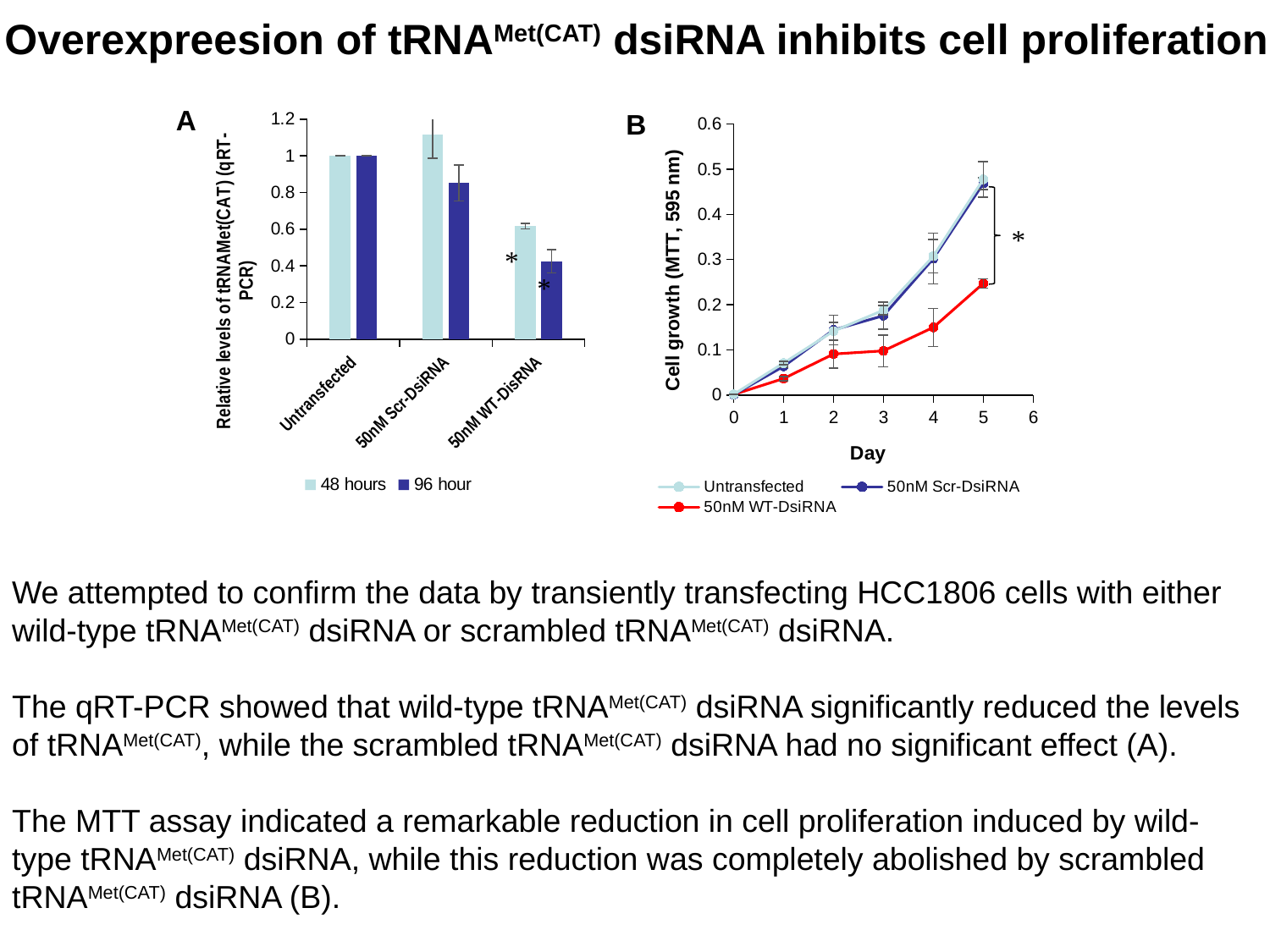
In chart A, how many categories are shown on the x axis? 3 In chart A, is the 48 hours value for 50nM WT-DisRNA greater or less than 0.8? less In chart A, is the 96 hour value for 50nM WT-DisRNA greater or less than 0.6? less In chart A, which category has the lowest 48 hours value? 50nM WT-DisRNA What kind of chart is chart A? bar chart In chart B, how many series does the legend list? 3 In chart B, what is the x-axis title? Day In chart A, what is the value for Untransfected at 48 hours? 1 In chart B, does the 50nM WT-DsiRNA series rise or fall from day 0 to day 5? rise In chart A, how many series does the legend list? 2 What kind of chart is chart B? line chart In chart B, at day 5, which is larger: Untransfected or 50nM WT-DsiRNA? Untransfected